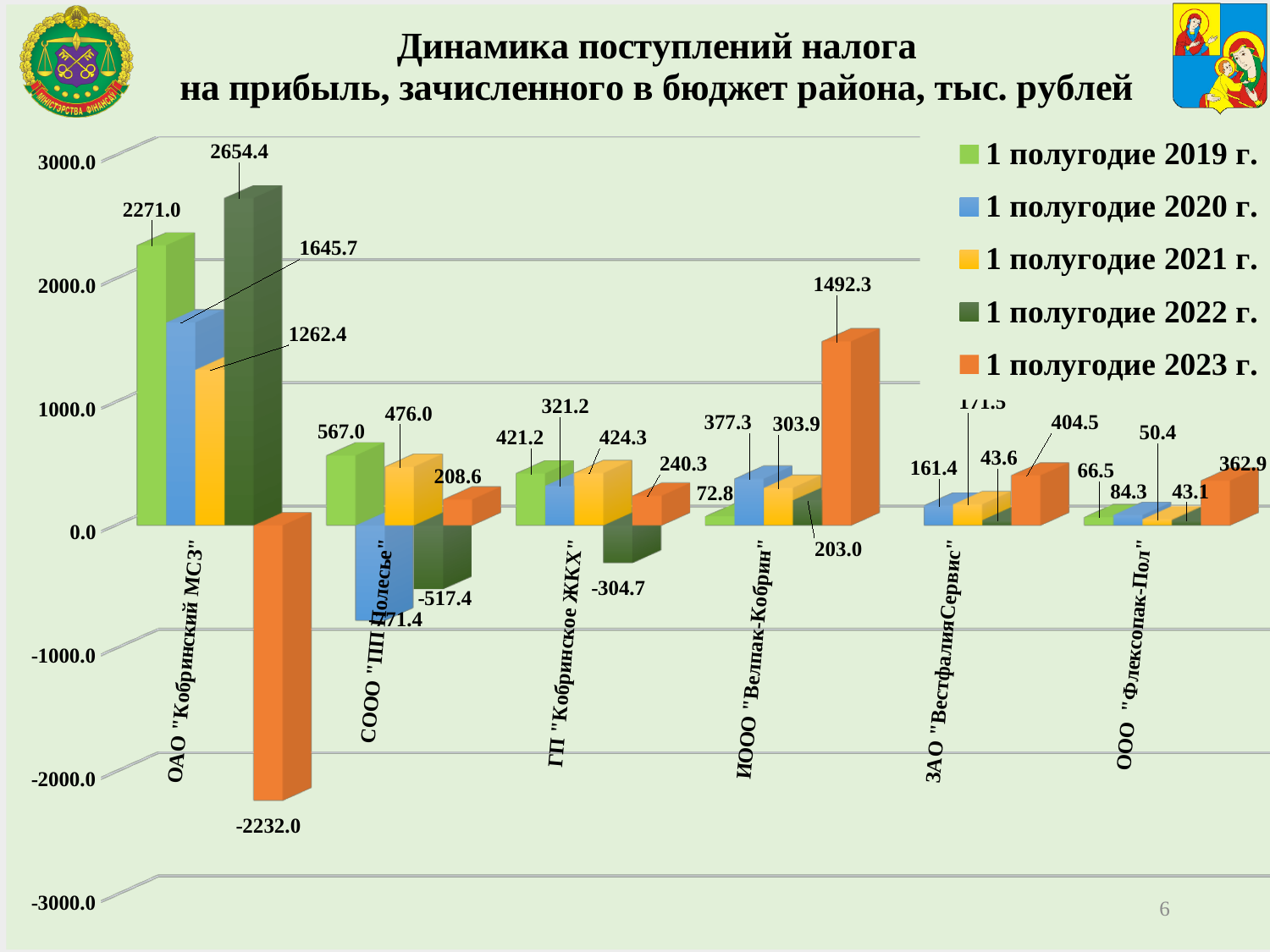
What is the difference between the 1 полугодие 2022 г. and 1 полугодие 2019 г. values for ОАО "Кобринский МСЗ"? 383.4 How many organisations (categories) are shown on the x axis? 6 How many series does the legend list? 5 What is the value for СООО "ПП Полесье" in 1 полугодие 2019 г.? 567.0 Which organisation has the highest value in 1 полугодие 2023 г.? ИООО "Велпак-Кобрин" Which is larger in 1 полугодие 2021 г.: СООО "ПП Полесье" or ГП "Кобринское ЖКХ"? СООО "ПП Полесье" What is the value for ИООО "Велпак-Кобрин" in 1 полугодие 2023 г.? 1492.3 What is the value for ГП "Кобринское ЖКХ" in 1 полугодие 2022 г.? -304.7 What is the value for ООО "Флексопак-Пол" in 1 полугодие 2023 г.? 362.9 What is the value for ОАО "Кобринский МСЗ" in 1 полугодие 2023 г.? -2232.0 What is the value for ОАО "Кобринский МСЗ" in 1 полугодие 2022 г.? 2654.4 What kind of chart is shown on the slide? Bar chart